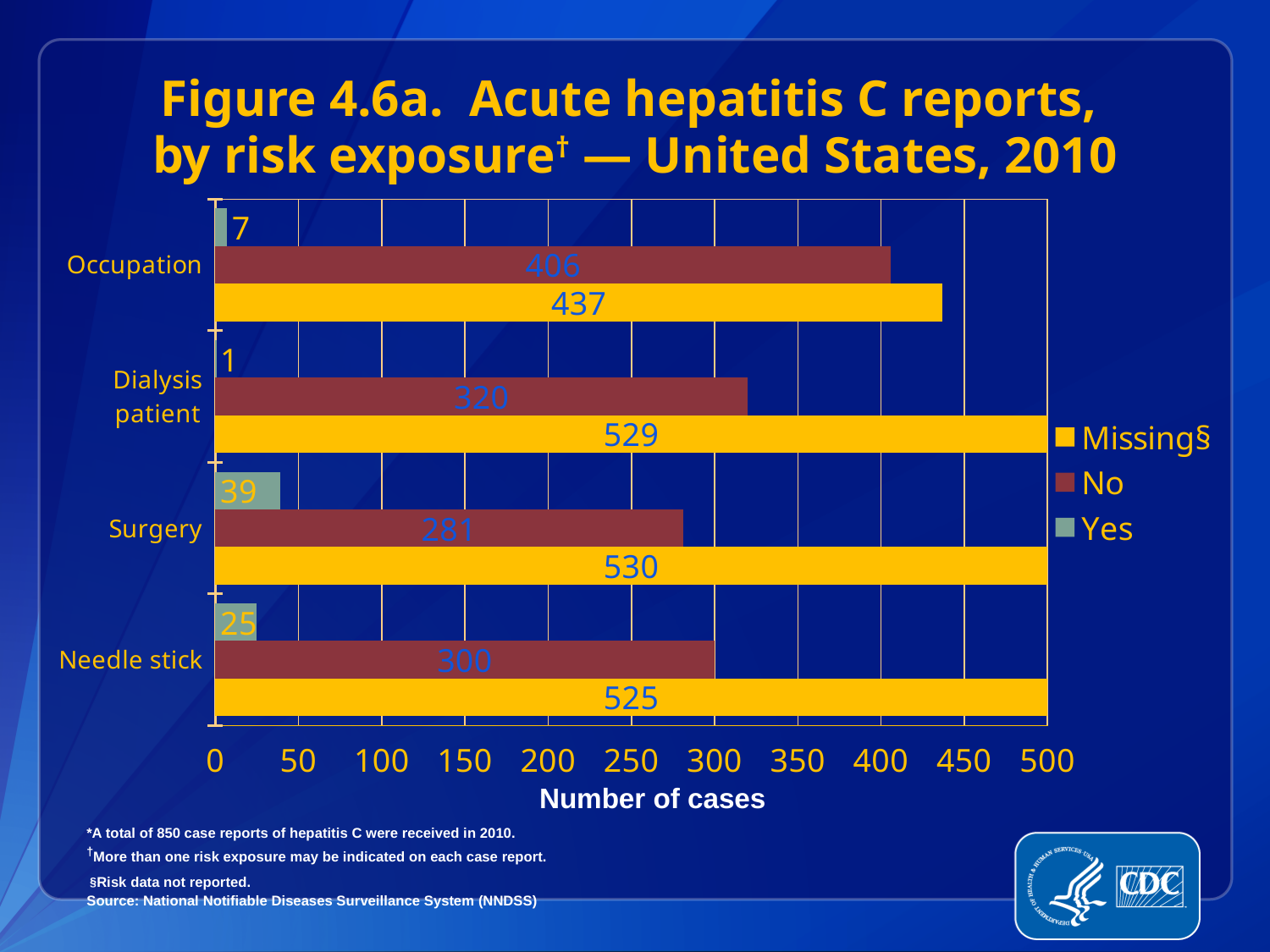
What is the label of the x axis? Number of cases Which is larger, the 'No' value for Dialysis patient or the 'No' value for Needle stick? Dialysis patient What is the number of cases for 'Yes' in the Needle stick category? 25 What is the difference between the 'No' values for Occupation and Surgery? 125 Which category has the highest 'No' value? Occupation What is the number of cases for 'No' in the Occupation category? 406 What is the number of cases for 'Yes' in the Surgery category? 39 What is the number of cases for 'Missing' in the Dialysis patient category? 529 Which category has the lowest 'Yes' value? Dialysis patient How many risk exposure categories are shown on the chart? 4 What type of chart is shown on the slide? bar chart How many series does the legend list? 3